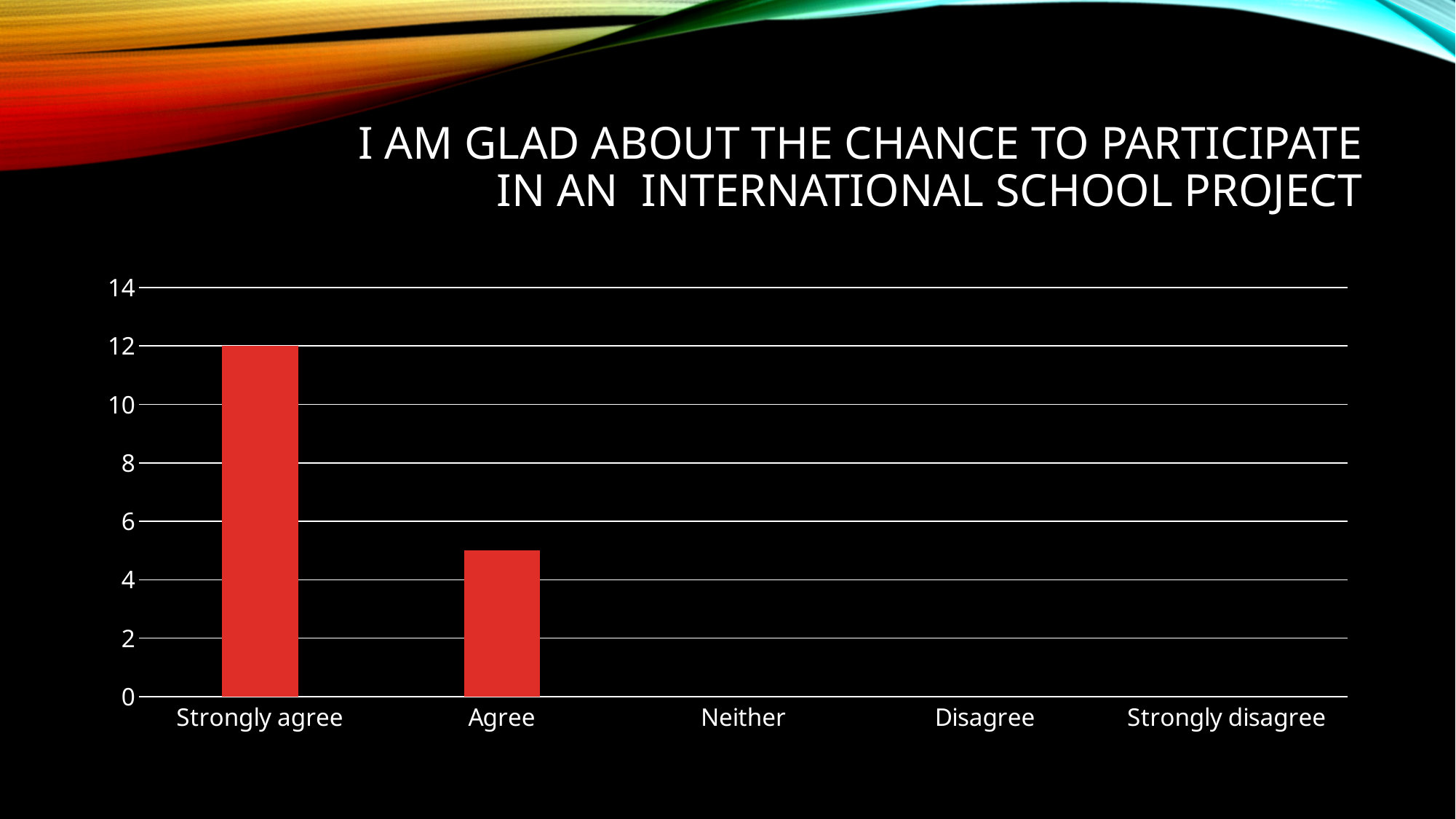
How many categories are shown on the x axis? 5 What is the value for Strongly agree? 12 Is the value for Strongly agree greater or less than 10? greater What colour are the bars in the chart? red Which category has the highest value? Strongly agree Do the values rise or fall from Strongly agree to Agree? fall Is the value for Agree greater or less than 4? greater What kind of chart is shown on the slide? bar chart What is the title of the slide? I am glad about the chance to participate in an international school project Which is larger, the value for Agree or the value for Neither? Agree Which is larger, the value for Strongly agree or the value for Agree? Strongly agree Is the value for Agree greater or less than 6? less